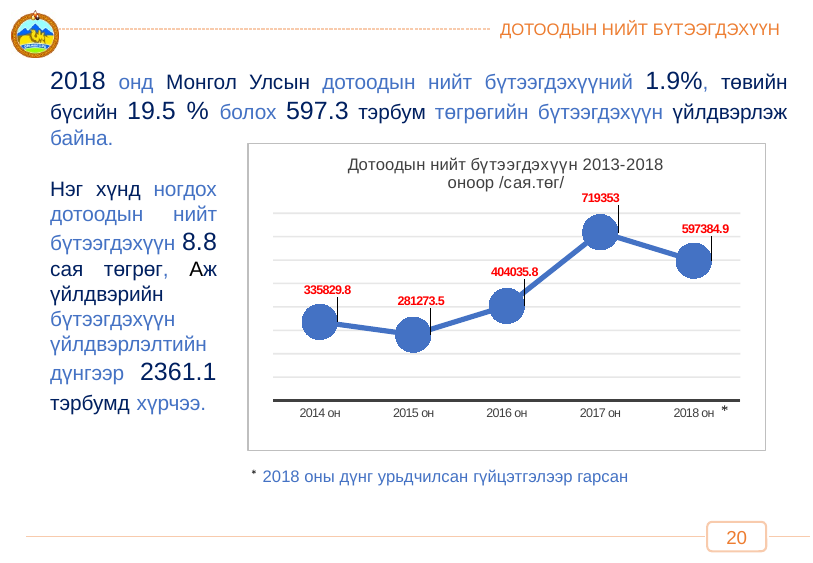
Which year has the highest value? 2017 он How many years are plotted on the chart? 5 Which year has the lowest value? 2015 он What is the title of the chart? Дотоодын нийт бүтээгдэхүүн 2013-2018 оноор /сая.төг/ What is the difference between the values for 2016 он and 2015 он? 122762.3 Which is larger, the value for 2014 он or the value for 2016 он? 2016 он What kind of chart is shown on the slide? line chart What is the value for 2014 он? 335829.8 What is the difference between the values for 2017 он and 2018 он? 121968.1 What is the value for 2017 он? 719353 What is the value for 2018 он? 597384.9 What is the value for 2015 он? 281273.5